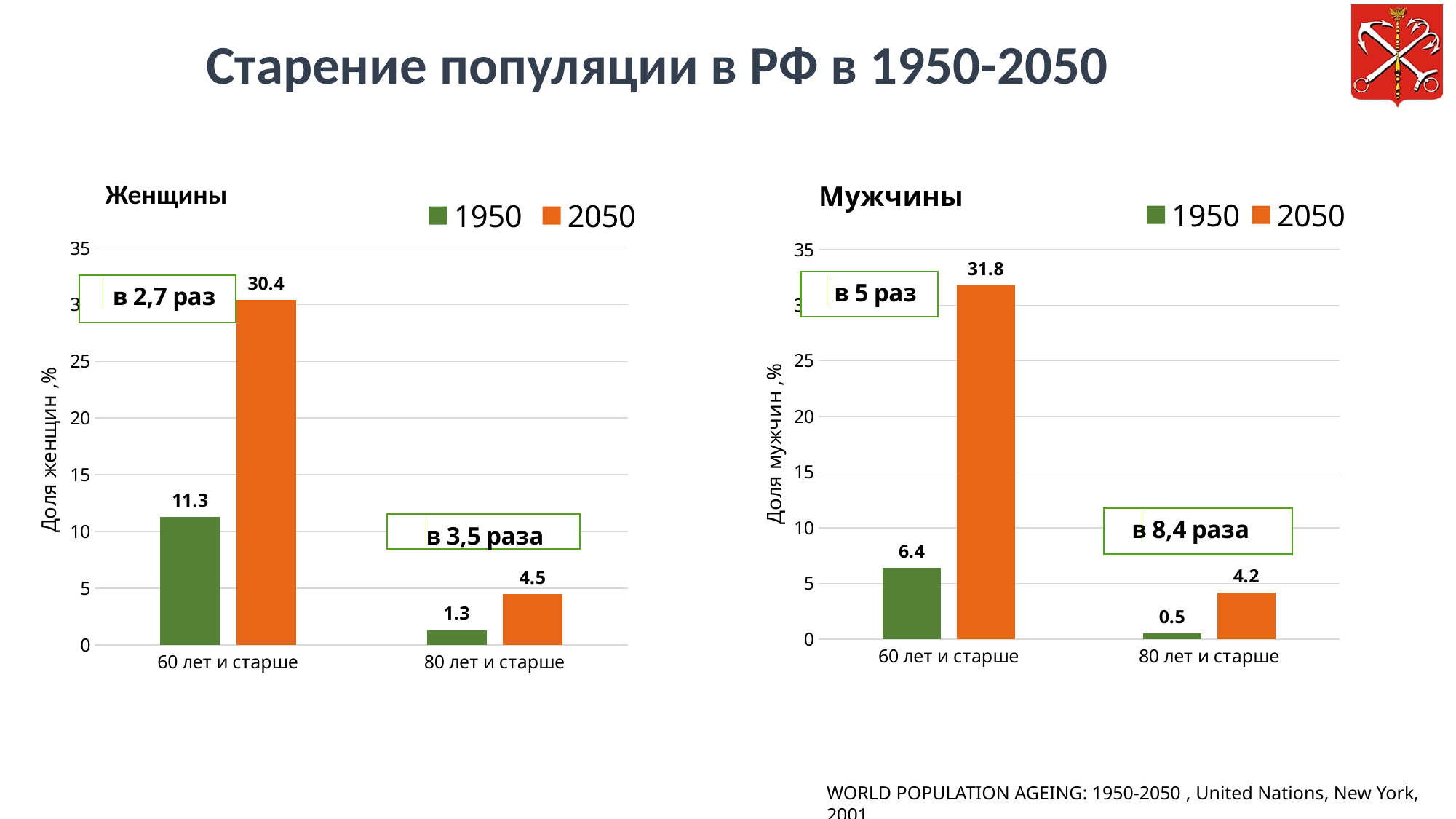
In the Мужчины chart, what is the value for 1950 in the 60 лет и старше category? 6.4 In the Мужчины chart, which bar has the highest value? 2050, 60 лет и старше In the Женщины chart, what is the value for 2050 in the 60 лет и старше category? 30.4 What type of chart is the Женщины chart? Bar chart In the Женщины chart, what is the difference between the 2050 and 1950 values for 60 лет и старше? 19.1 In the Мужчины chart, what is the value for 2050 in the 80 лет и старше category? 4.2 Which is larger: the 2050 value for 60 лет и старше in the Женщины chart or in the Мужчины chart? Мужчины In the Мужчины chart, what is the difference between the 2050 and 1950 values for 80 лет и старше? 3.7 In the Женщины chart, what is the value for 1950 in the 80 лет и старше category? 1.3 How many series does the legend of the Женщины chart list? 2 How many categories are shown on the x axis of the Мужчины chart? 2 In the Мужчины chart, which bar has the lowest value? 1950, 80 лет и старше